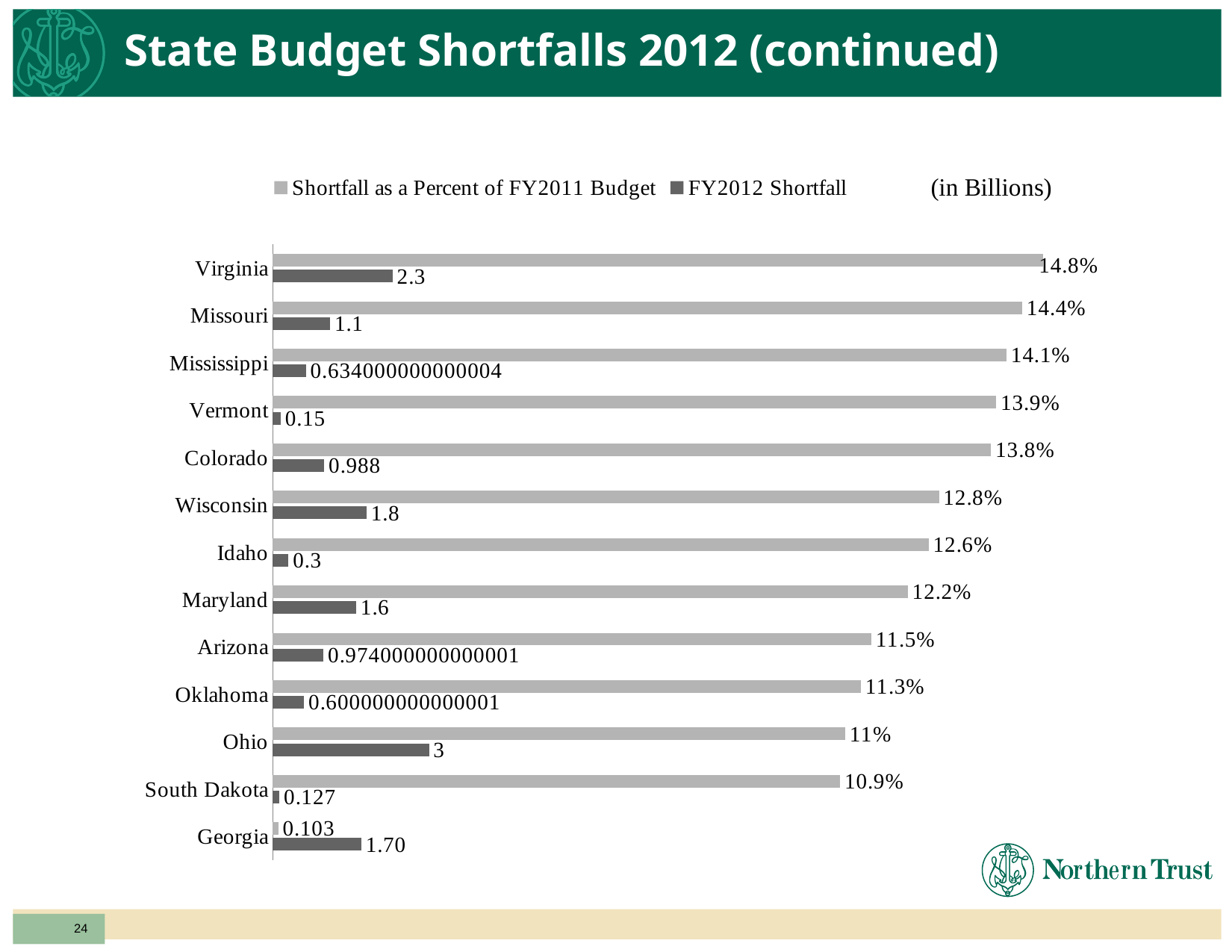
What is the FY2012 Shortfall value shown for Ohio? 3 How many series does the legend list? 2 Which state has the highest Shortfall as a Percent of FY2011 Budget? Virginia Which state has the lowest FY2012 Shortfall? South Dakota How many states are shown in the chart? 13 What is the difference between Virginia's and Missouri's Shortfall as a Percent of FY2011 Budget? 0.4% What is the difference between Ohio's and Virginia's FY2012 Shortfall values? 0.7 Which has the larger FY2012 Shortfall, Wisconsin or Maryland? Wisconsin Which state has the highest FY2012 Shortfall? Ohio What is the FY2012 Shortfall value shown for Colorado? 0.988 What kind of chart is shown on the slide? Bar chart What is the Shortfall as a Percent of FY2011 Budget for Virginia? 14.8%